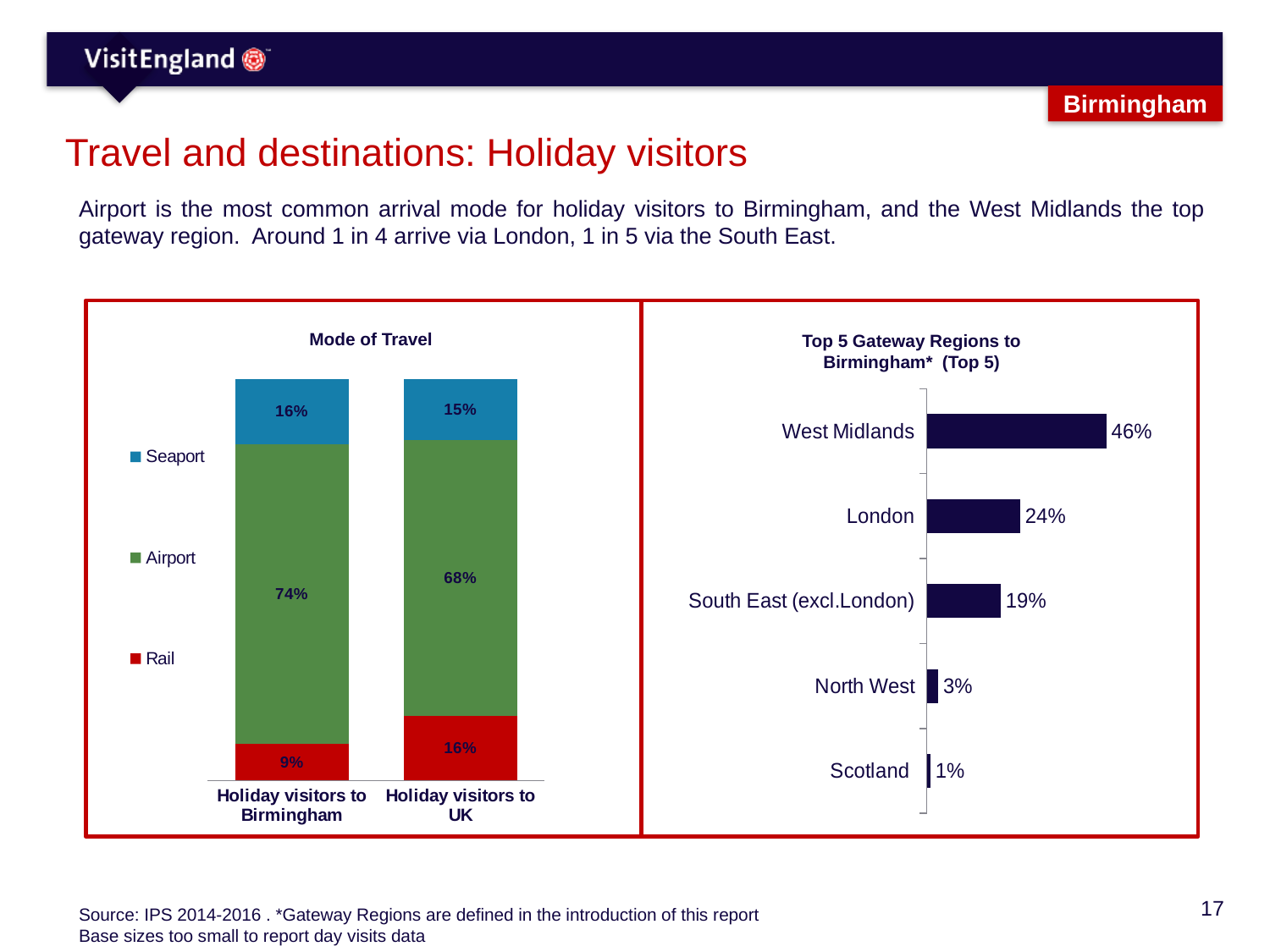
What kind of chart is the Top 5 Gateway Regions to Birmingham chart? Bar chart In the Mode of Travel chart, what is the difference between the Airport share for holiday visitors to Birmingham and for holiday visitors to the UK? 6 percentage points In the Top 5 Gateway Regions to Birmingham chart, how many regions are shown? 5 In the Mode of Travel chart, what is the Seaport share for holiday visitors to Birmingham? 16% In the Mode of Travel chart, which is larger: the Rail share for holiday visitors to Birmingham or for holiday visitors to the UK? Holiday visitors to UK In the Mode of Travel chart, what percentage of holiday visitors to Birmingham arrive by Airport? 74% In the Top 5 Gateway Regions to Birmingham chart, which region has the highest value? West Midlands In the Top 5 Gateway Regions to Birmingham chart, what is the value for London? 24% In the Mode of Travel chart, how many series does the legend list? 3 In the Top 5 Gateway Regions to Birmingham chart, which region has the lowest value? Scotland In the Top 5 Gateway Regions to Birmingham chart, what is the difference between West Midlands and South East (excl.London)? 27 percentage points In the Mode of Travel chart, what percentage of holiday visitors to the UK arrive by Rail? 16%